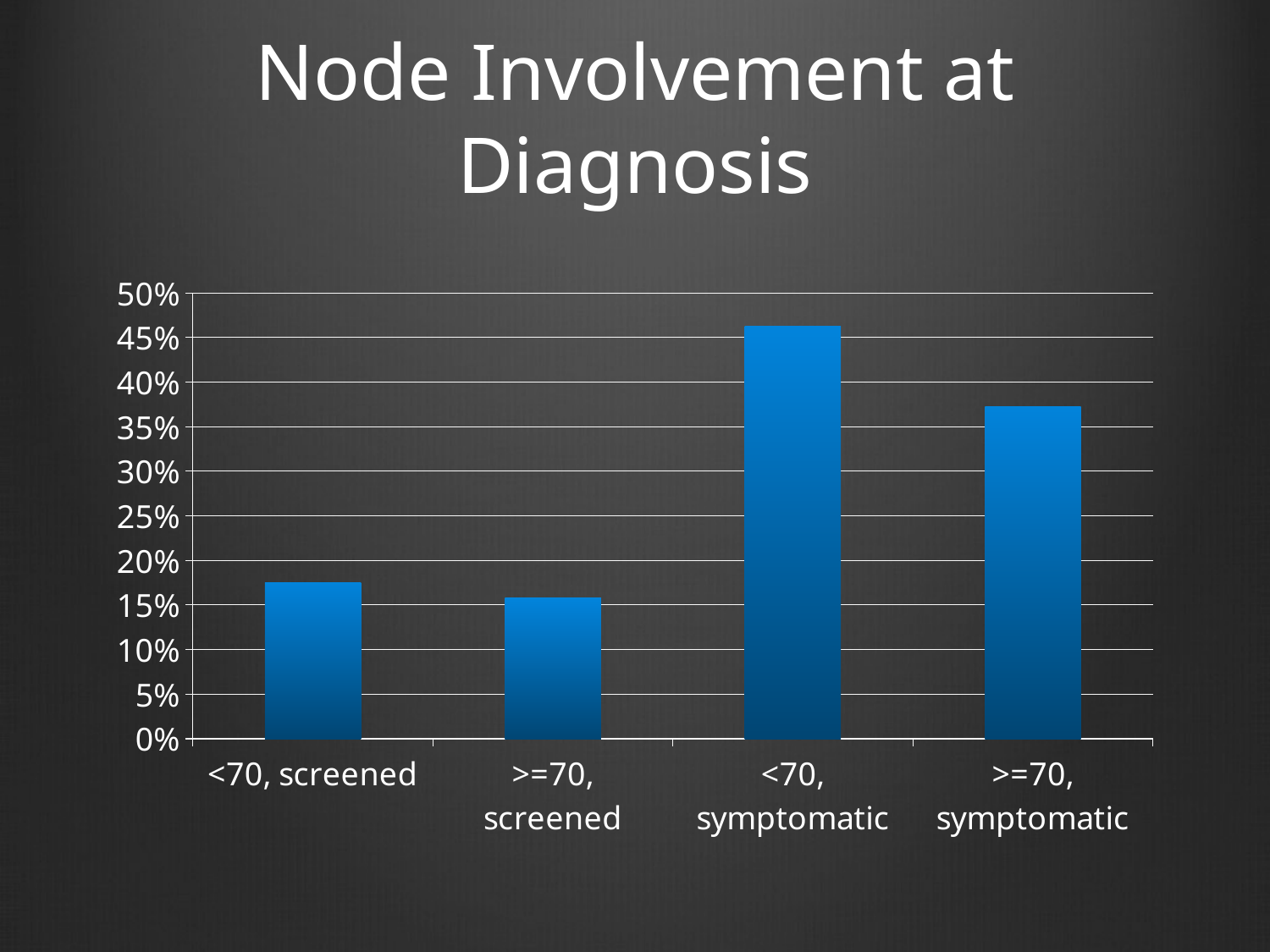
Which category has the highest value in the chart? <70, symptomatic Which is larger, the value for <70, symptomatic or the value for >=70, symptomatic? <70, symptomatic What is the highest value shown on the y axis of the chart? 50% Which is larger, the value for <70, screened or the value for <70, symptomatic? <70, symptomatic Is the value for >=70, symptomatic greater or less than 40%? less Is the value for <70, symptomatic greater or less than 40%? greater What kind of chart is shown on the slide? bar chart What is the title of the chart? Node Involvement at Diagnosis Is the value for <70, screened greater or less than 20%? less How many categories are shown on the x axis of the chart? 4